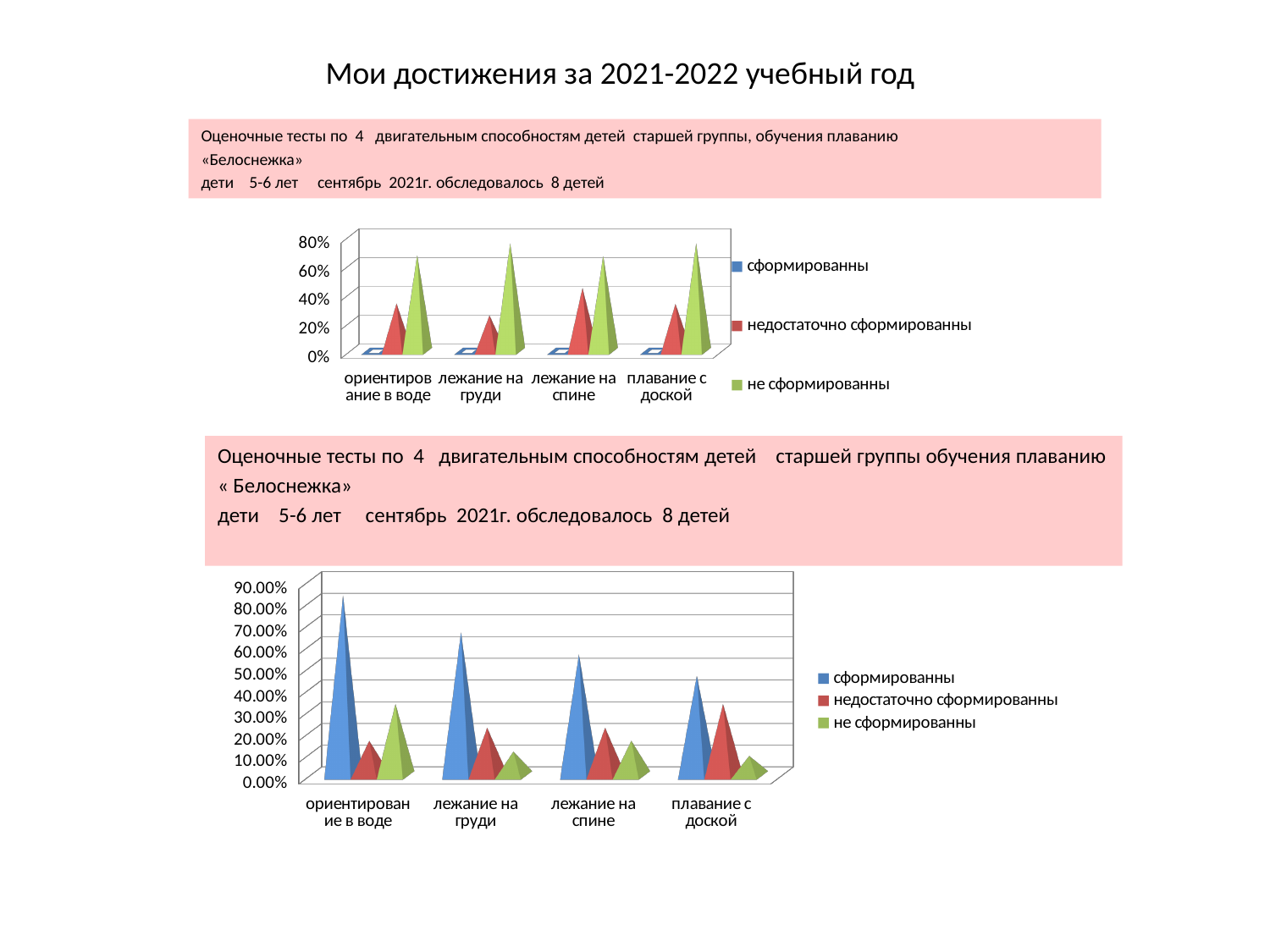
What colour represents the series не сформированны in the bottom chart? green In the top chart, is the value of недостаточно сформированны for лежание на груди greater or less than 40%? less In the bottom chart, is the value of сформированны for ориентирование в воде greater or less than 70.00%? greater In the top chart, is the value of не сформированны for плавание с доской greater or less than 60%? greater What kind of chart is the top chart on the slide? bar chart In the bottom chart, do the values of сформированны rise or fall from left to right along the x axis? fall In the bottom chart, which category has the highest value for сформированны? ориентирование в воде How many categories are shown on the x axis of the bottom chart? 4 In the top chart, which series has the highest values across all categories? не сформированны In the bottom chart, which is larger for плавание с доской: сформированны or не сформированны? сформированны In the bottom chart, which category has the highest value for не сформированны? ориентирование в воде How many series does the legend of the top chart list? 3